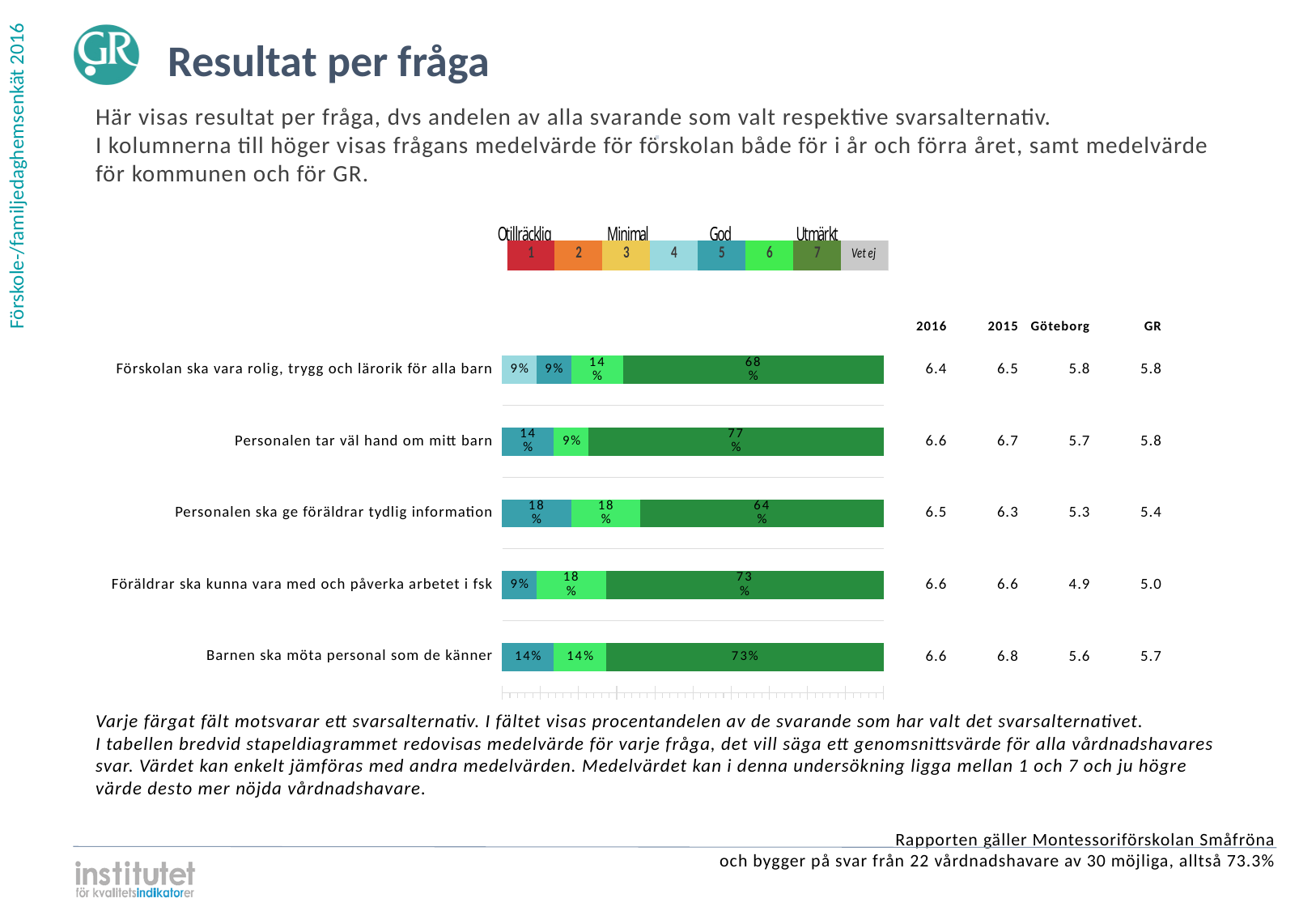
How many answer alternatives does the legend above the chart list? 8 How many questions (bars) are shown in the chart? 5 What percentage of respondents chose answer 7 (dark green) for "Personalen tar väl hand om mitt barn"? 77% Which question has the smallest share of respondents choosing answer 7 (dark green)? Personalen ska ge föräldrar tydlig information What is the 2016 mean value shown for "Personalen ska ge föräldrar tydlig information"? 6.5 What is the difference between the answer-7 share for "Personalen tar väl hand om mitt barn" and for "Personalen ska ge föräldrar tydlig information"? 13% What is the total of the labelled segments in the bar for "Förskolan ska vara rolig, trygg och lärorik för alla barn"? 100% What type of chart is used to show the results per question? Stacked bar chart What percentage of respondents chose answer 7 (dark green) for "Förskolan ska vara rolig, trygg och lärorik för alla barn"? 68% What percentage of respondents chose answer 6 (light green) for "Personalen ska ge föräldrar tydlig information"? 18% Which has a larger answer-7 (dark green) share: "Barnen ska möta personal som de känner" or "Förskolan ska vara rolig, trygg och lärorik för alla barn"? Barnen ska möta personal som de känner Which question has the largest share of respondents choosing answer 7 (dark green)? Personalen tar väl hand om mitt barn